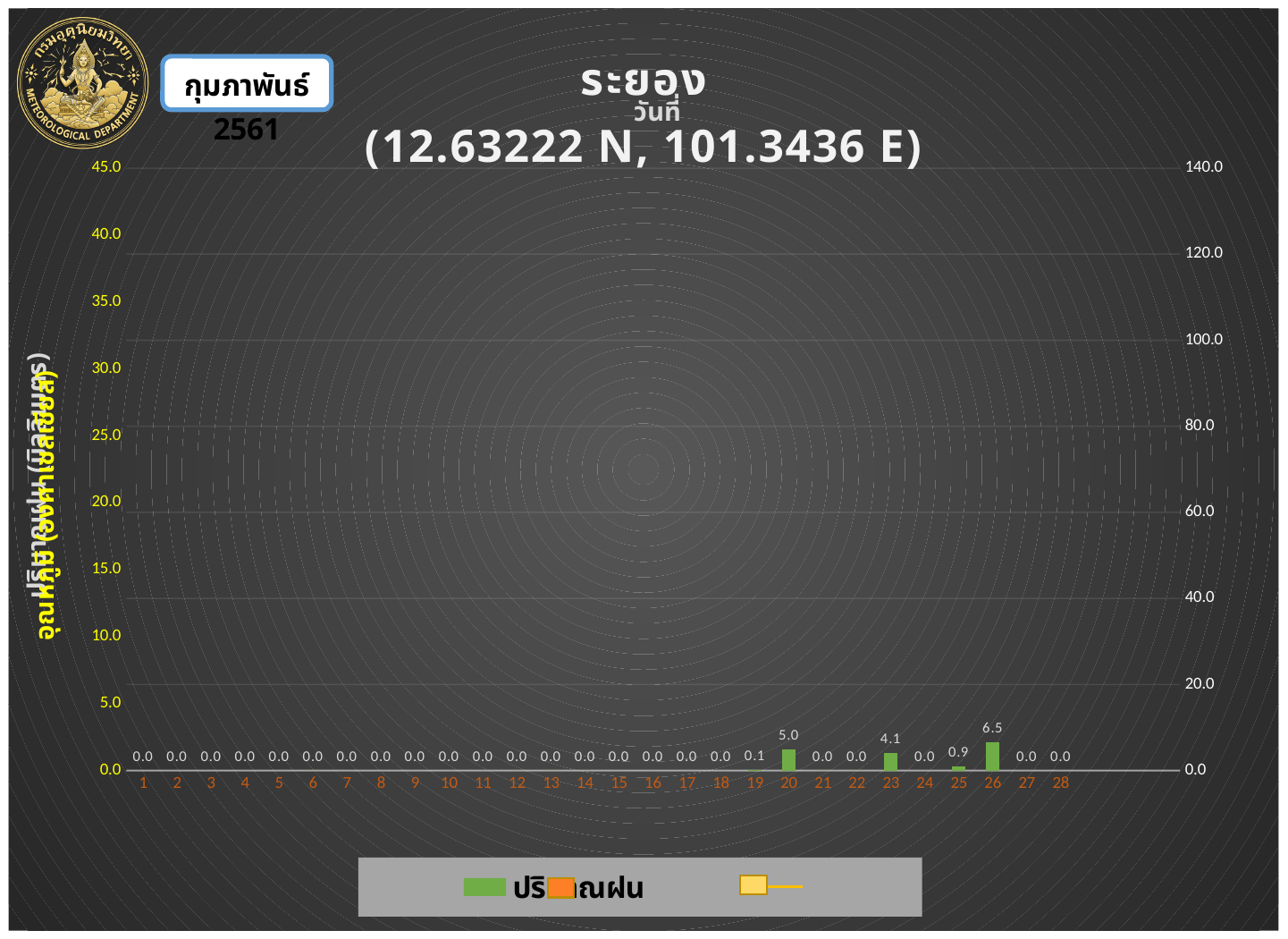
What is the station name shown in the chart title? ระยอง What is the rainfall value shown for day 26? 6.5 What is the rainfall value shown for day 19? 0.1 What kind of chart is shown on the slide? bar chart What is the rainfall value shown for day 23? 4.1 What is the difference between the rainfall values for day 20 and day 23? 0.9 Which is larger, the rainfall value for day 23 or for day 25? day 23 How many days are shown on the x axis? 28 What is the rainfall value shown for day 25? 0.9 Which day has the highest rainfall value? 26 What is the difference between the rainfall values for day 26 and day 20? 1.5 What is the rainfall value shown for day 20? 5.0